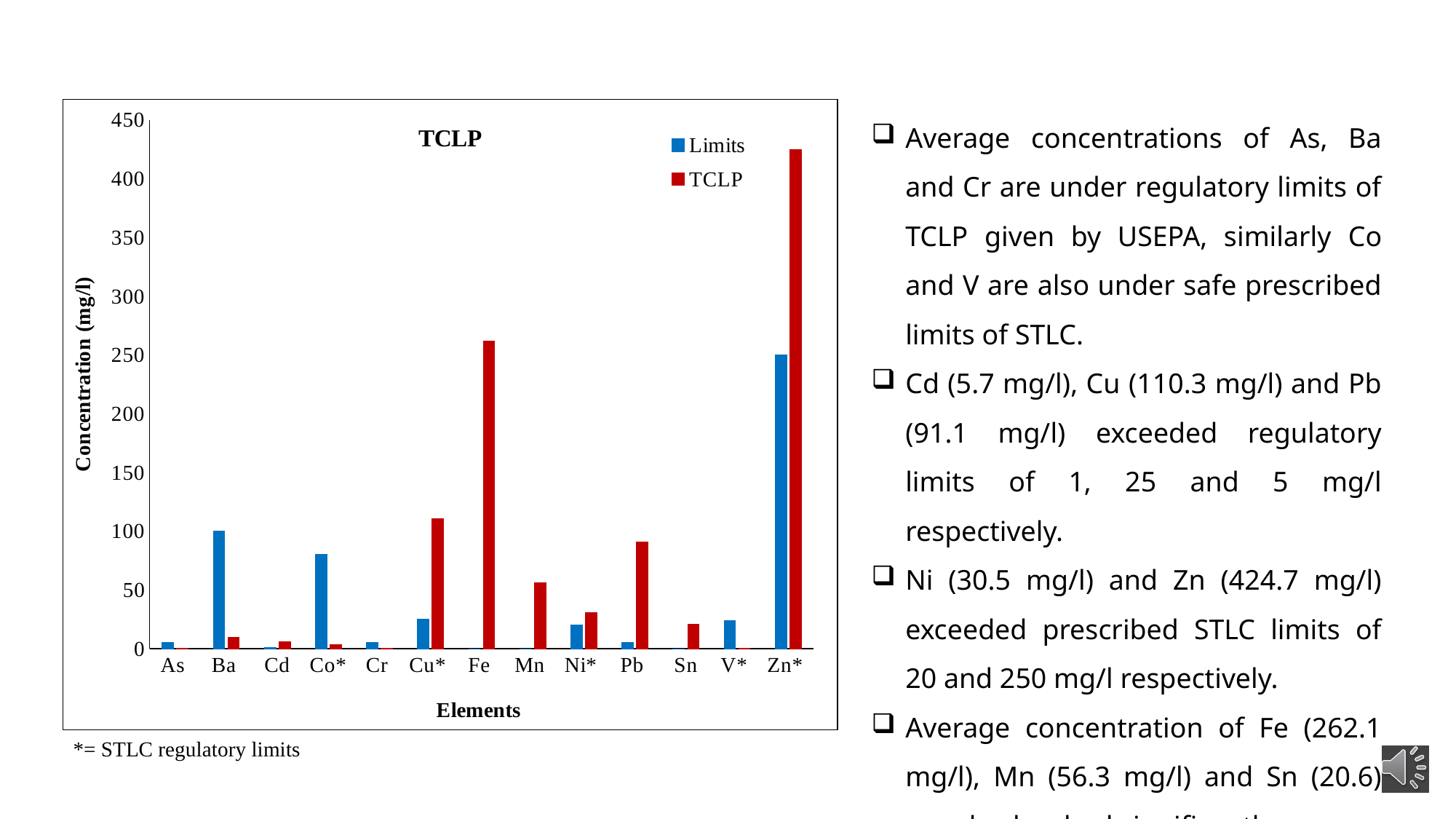
For Cu*, which is larger, the Limits value or the TCLP value? TCLP What is the Limits value for Ba? 100 How many elements are shown on the x axis of the chart? 13 Is the TCLP value for Pb greater or less than 100? less What is the Limits value for Zn*? 250 Is the TCLP value for Zn* greater or less than 400? greater Which element has the highest Limits value? Zn* What kind of chart is shown on the slide? bar chart Is the TCLP value for Fe greater or less than 250? greater What is the label on the y axis of the chart? Concentration (mg/l) Which element has the highest TCLP value? Zn* How many series does the legend list? 2